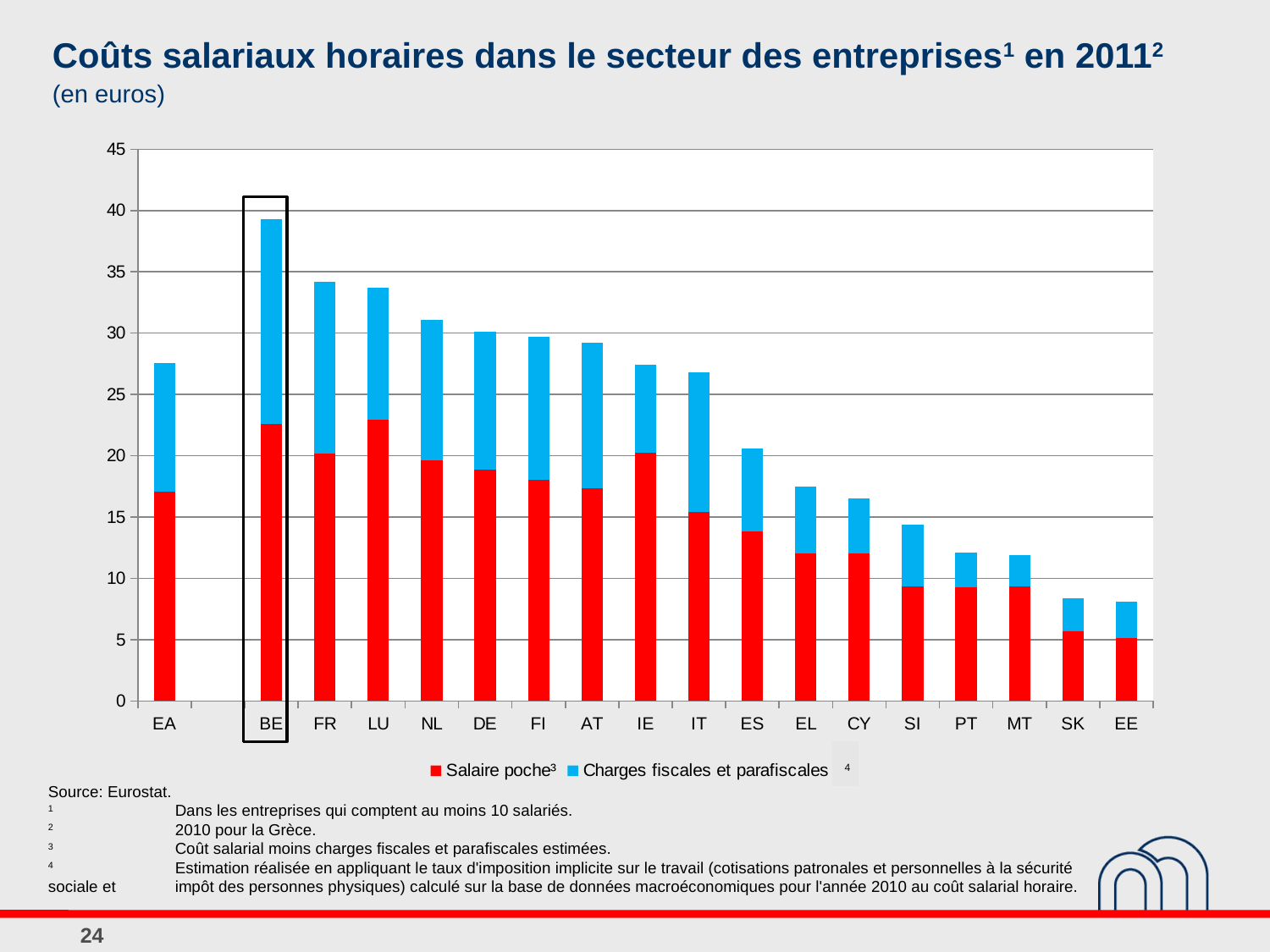
Is the total bar for FR greater or less than 30? greater How many series does the legend list? 2 Moving from BE to EE along the x axis, do the total bar heights rise or fall? fall Is the total bar for BE greater or less than 35? greater Which country has the highest total hourly labour cost in the chart? BE Is the 'Salaire poche' value for LU greater or less than 20? greater Which has the larger total bar, LU or NL? LU How many countries or regions are shown on the x axis of the chart? 18 What kind of chart is shown on the slide? stacked bar chart Which country's bar is outlined with a black rectangle on the chart? BE